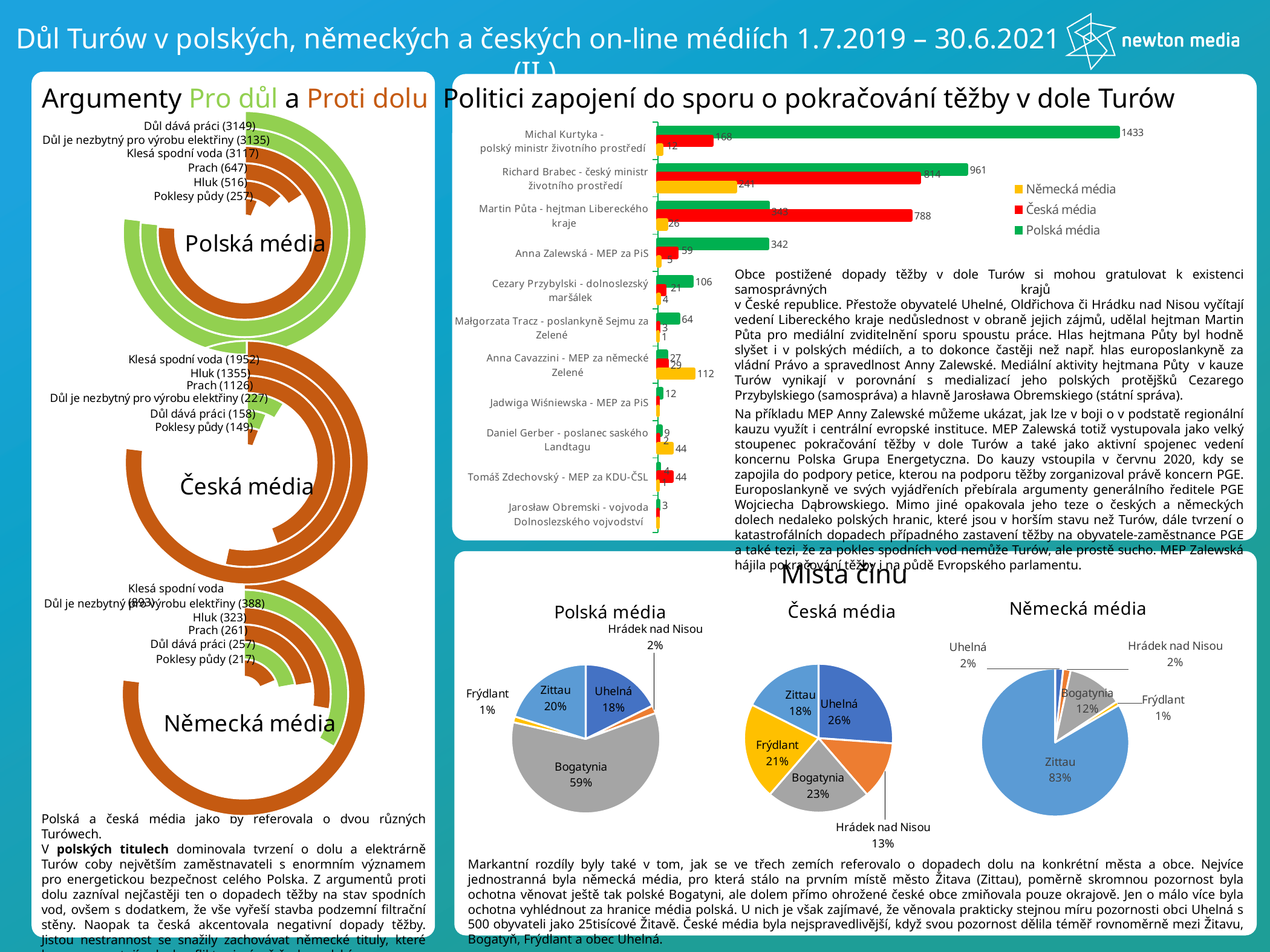
In the 'Argumenty Pro důl a Proti dolu' chart for Polská média, what is the value for 'Důl dává práci'? 3149 In the 'Místa činu' pie chart for Česká média, how many slices are there? 5 In the 'Politici zapojení do sporu o pokračování těžby v dole Turów' bar chart, what is the value for Michal Kurtyka in Polská média? 1433 In the 'Politici zapojení do sporu o pokračování těžby v dole Turów' bar chart, which is larger for Anna Cavazzini: Německá média or Česká média? Německá média In the 'Politici zapojení do sporu o pokračování těžby v dole Turów' bar chart, how many series does the legend list? 3 In the 'Argumenty Pro důl a Proti dolu' chart for Česká média, which argument has the lowest value? Poklesy půdy In the 'Místa činu' pie chart for Polská média, what share does Bogatynia have? 59% In the 'Politici zapojení do sporu o pokračování těžby v dole Turów' bar chart, what is the value for Martin Půta in Česká média? 788 In the 'Politici zapojení do sporu o pokračování těžby v dole Turów' bar chart, which politician has the highest value in Polská média? Michal Kurtyka In the 'Místa činu' pie chart for Česká média, what share does Frýdlant have? 21% In the 'Místa činu' pie chart for Německá média, which place has the largest share? Zittau In the 'Politici zapojení do sporu o pokračování těžby v dole Turów' bar chart, what is the difference between Richard Brabec's Polská média value and his Česká média value? 147